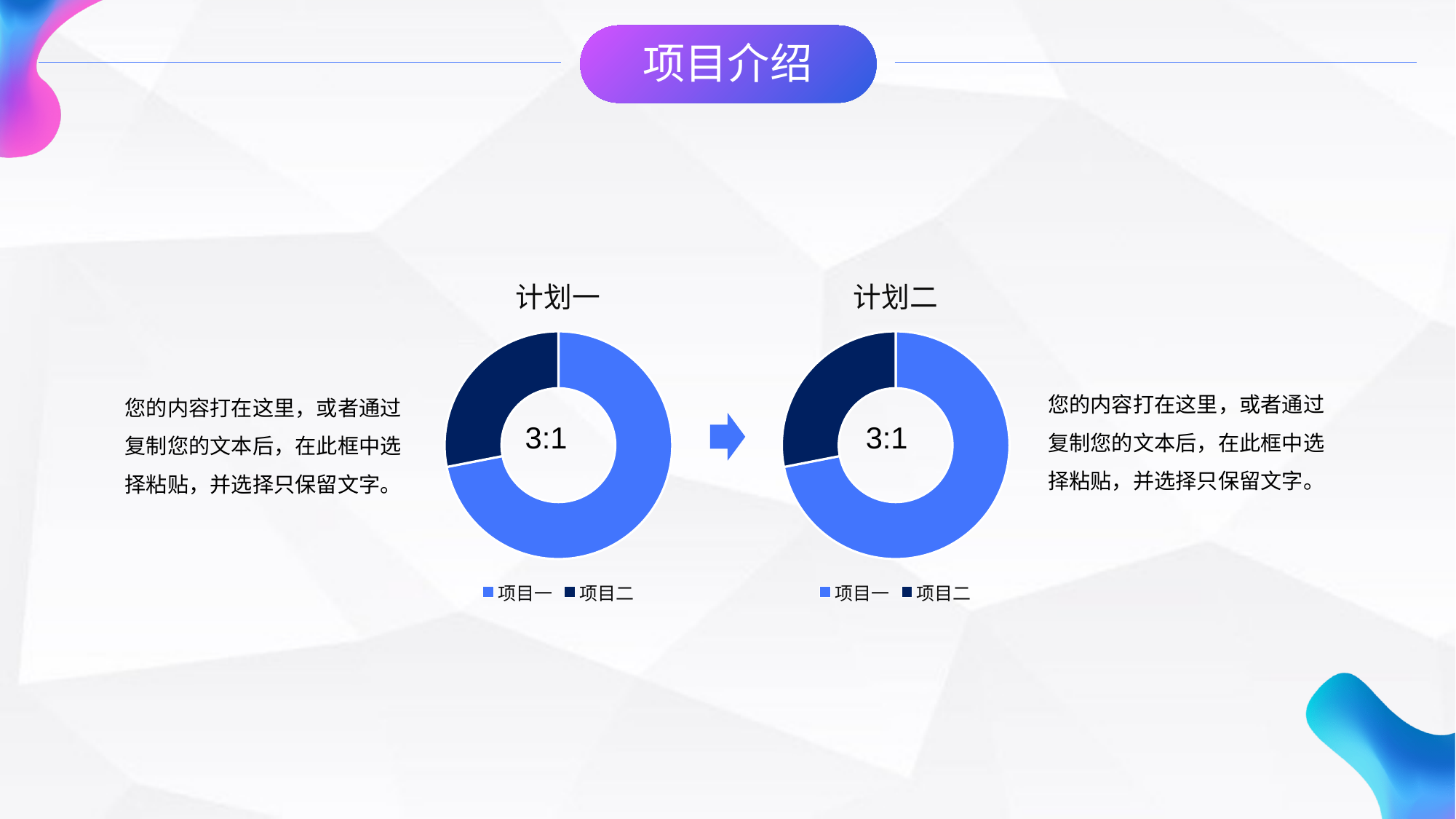
How many categories does the 计划一 chart show? 2 What is the title of the chart on the right? 计划二 How many entries does the legend of the 计划二 chart list? 2 What kind of chart is the 计划二 chart? doughnut chart What kind of chart is the 计划一 chart? doughnut chart In the 计划二 chart, which slice is larger, 项目一 or 项目二? 项目一 In the 计划一 chart, which slice is larger, 项目一 or 项目二? 项目一 In the 计划二 chart, which category has the smallest slice? 项目二 What text is shown in the centre of the 计划一 chart? 3:1 In the 计划二 chart, which category has the largest slice? 项目一 In the 计划一 chart, which category has the largest slice? 项目一 In the 计划一 chart, which category has the smallest slice? 项目二